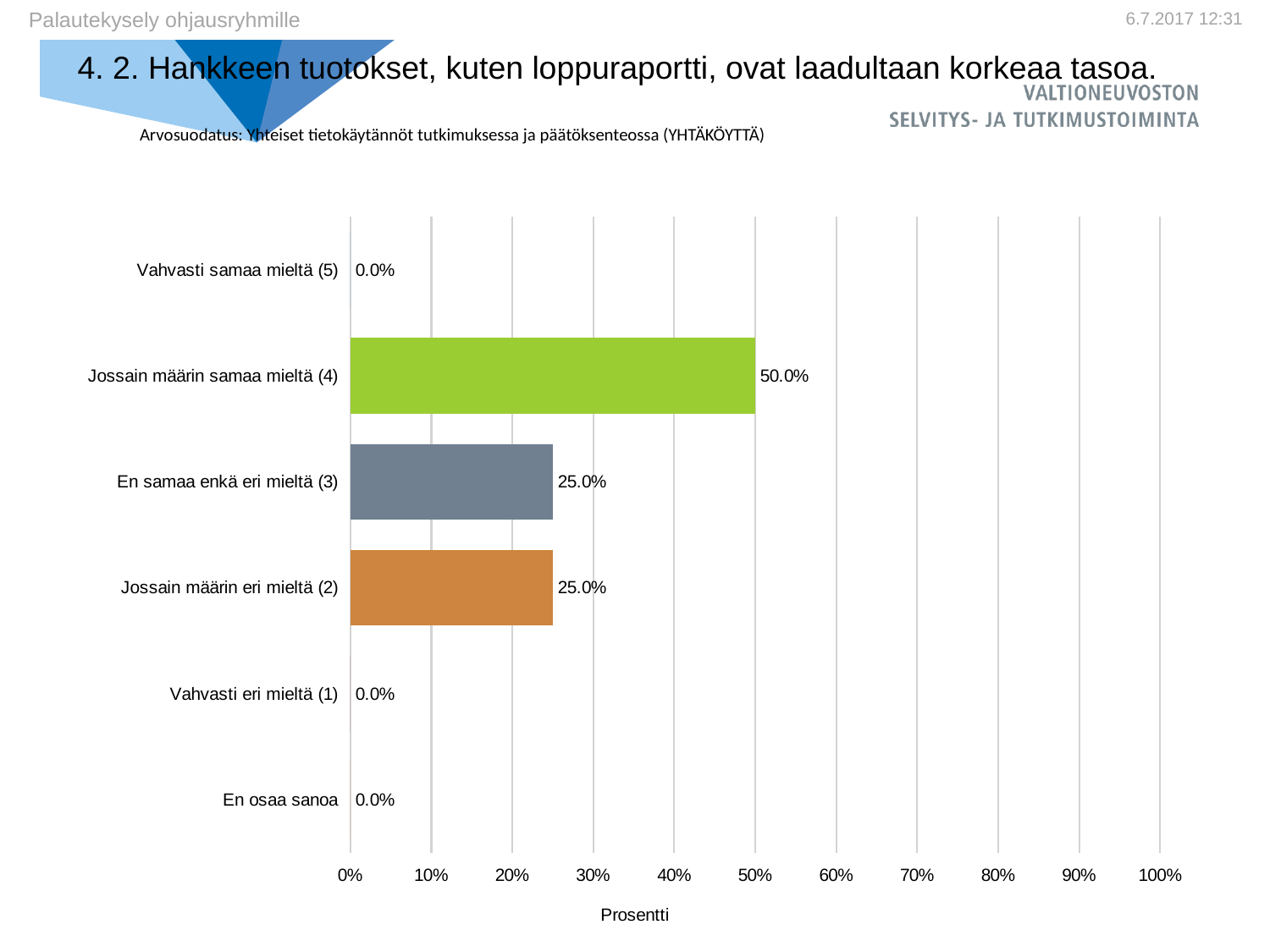
What colour is the bar for "Jossain määrin samaa mieltä (4)"? green What is the value for "Vahvasti samaa mieltä (5)"? 0.0% What is the label of the horizontal axis? Prosentti Which category has the highest value? Jossain määrin samaa mieltä (4) What is the value for "En samaa enkä eri mieltä (3)"? 25.0% How many categories are shown on the chart? 6 What is the value for "En osaa sanoa"? 0.0% What kind of chart is shown on the slide? bar chart Which is larger, the value for "Jossain määrin samaa mieltä (4)" or the value for "En samaa enkä eri mieltä (3)"? Jossain määrin samaa mieltä (4) What is the value for "Jossain määrin samaa mieltä (4)"? 50.0% What is the difference between the values for "Jossain määrin samaa mieltä (4)" and "Jossain määrin eri mieltä (2)"? 25.0% Is the value for "Jossain määrin eri mieltä (2)" greater or less than 30%? less